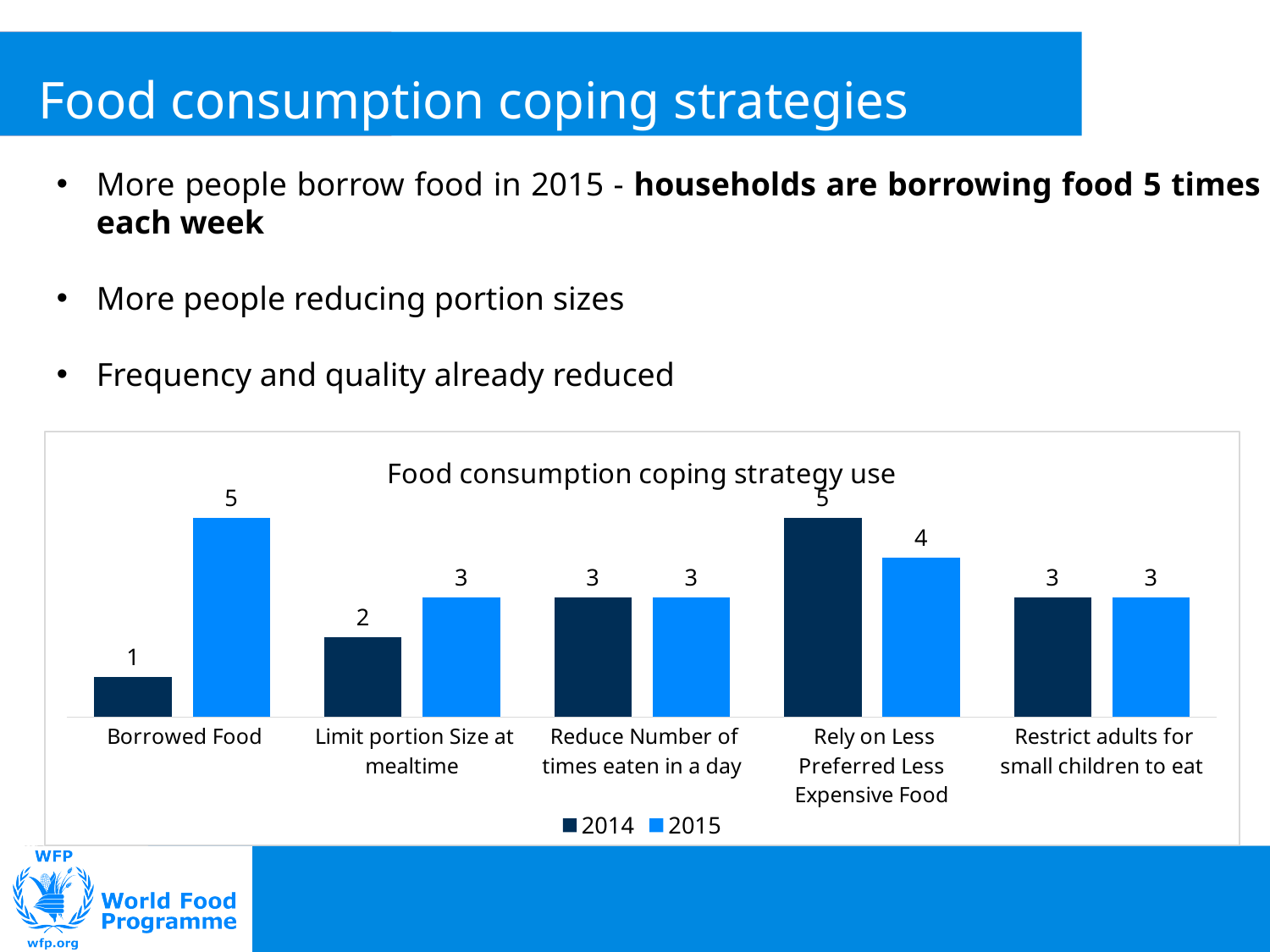
How many series does the legend list? 2 What is the 2015 value for Restrict adults for small children to eat? 3 What is the 2014 value for Limit portion Size at mealtime? 2 What kind of chart is shown? Bar chart What is the difference between the 2015 and 2014 values for Borrowed Food? 4 What is the 2014 value for Rely on Less Preferred Less Expensive Food? 5 What is the title of the chart? Food consumption coping strategy use Which category has the lowest 2014 value? Borrowed Food For Rely on Less Preferred Less Expensive Food, which year has the larger value, 2014 or 2015? 2014 What is the 2015 value for Borrowed Food? 5 Which category has the highest 2015 value? Borrowed Food How many categories are shown on the x axis? 5